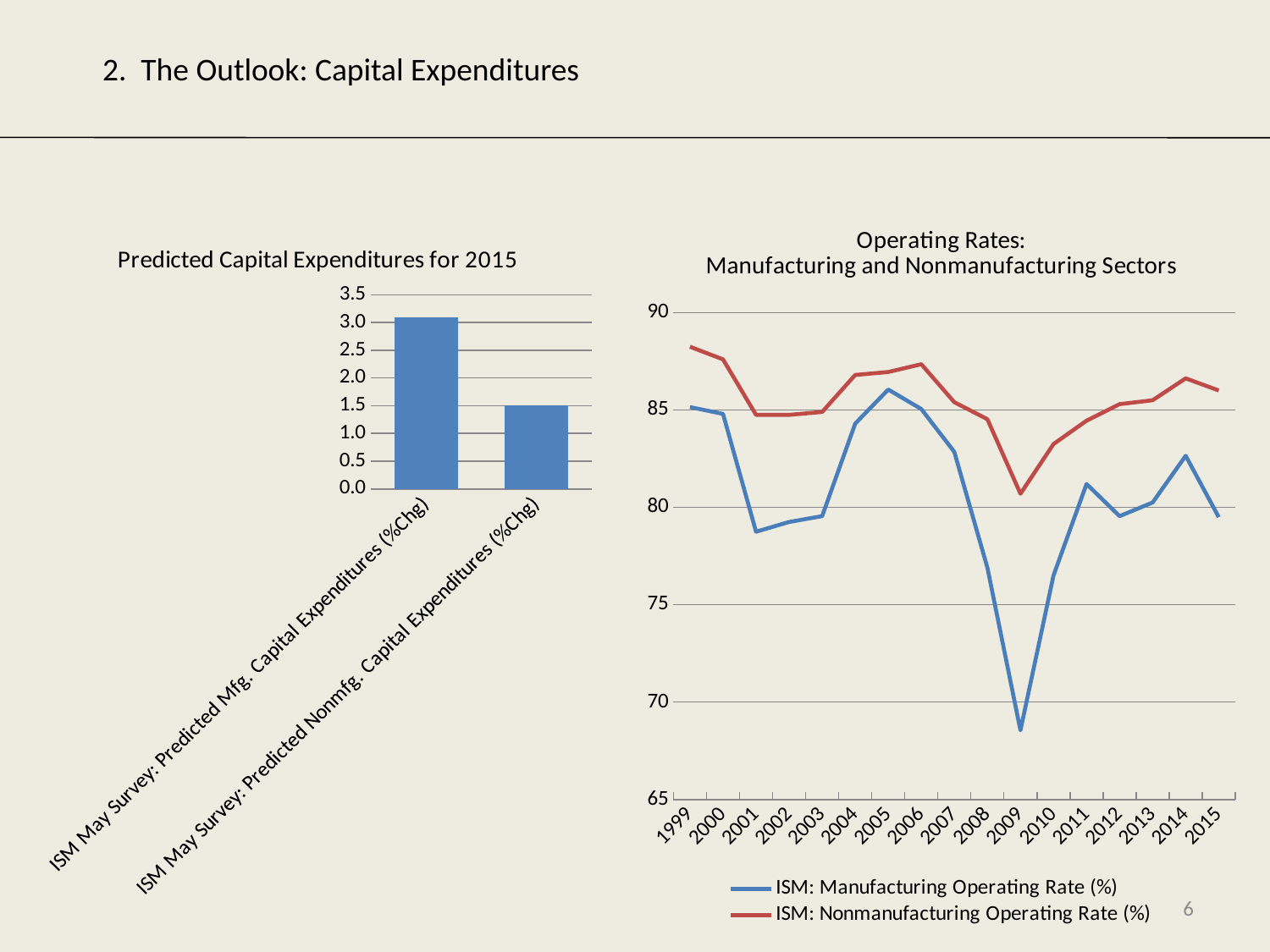
In the 'Operating Rates: Manufacturing and Nonmanufacturing Sectors' chart, in which year is the ISM: Manufacturing Operating Rate (%) lowest? 2009 In the 'Predicted Capital Expenditures for 2015' chart, what is the value for ISM May Survey: Predicted Nonmfg. Capital Expenditures (%Chg)? 1.5 In the 'Predicted Capital Expenditures for 2015' chart, which category has the higher value? ISM May Survey: Predicted Mfg. Capital Expenditures (%Chg) In the 'Operating Rates: Manufacturing and Nonmanufacturing Sectors' chart, how many years are shown on the x axis? 17 In the 'Predicted Capital Expenditures for 2015' chart, is the value for ISM May Survey: Predicted Mfg. Capital Expenditures (%Chg) greater or less than 3.0? greater What type of chart is the 'Predicted Capital Expenditures for 2015' chart? bar chart In the 'Operating Rates: Manufacturing and Nonmanufacturing Sectors' chart, is the ISM: Manufacturing Operating Rate (%) in 2009 greater or less than 70? less In the 'Operating Rates: Manufacturing and Nonmanufacturing Sectors' chart, does the ISM: Manufacturing Operating Rate (%) rise or fall from 2005 to 2009? fall How many series does the legend of the 'Operating Rates: Manufacturing and Nonmanufacturing Sectors' chart list? 2 What type of chart is the 'Operating Rates: Manufacturing and Nonmanufacturing Sectors' chart? line chart In the 'Predicted Capital Expenditures for 2015' chart, how many bars are plotted? 2 In the 'Operating Rates: Manufacturing and Nonmanufacturing Sectors' chart, which series is higher in 2009? ISM: Nonmanufacturing Operating Rate (%)